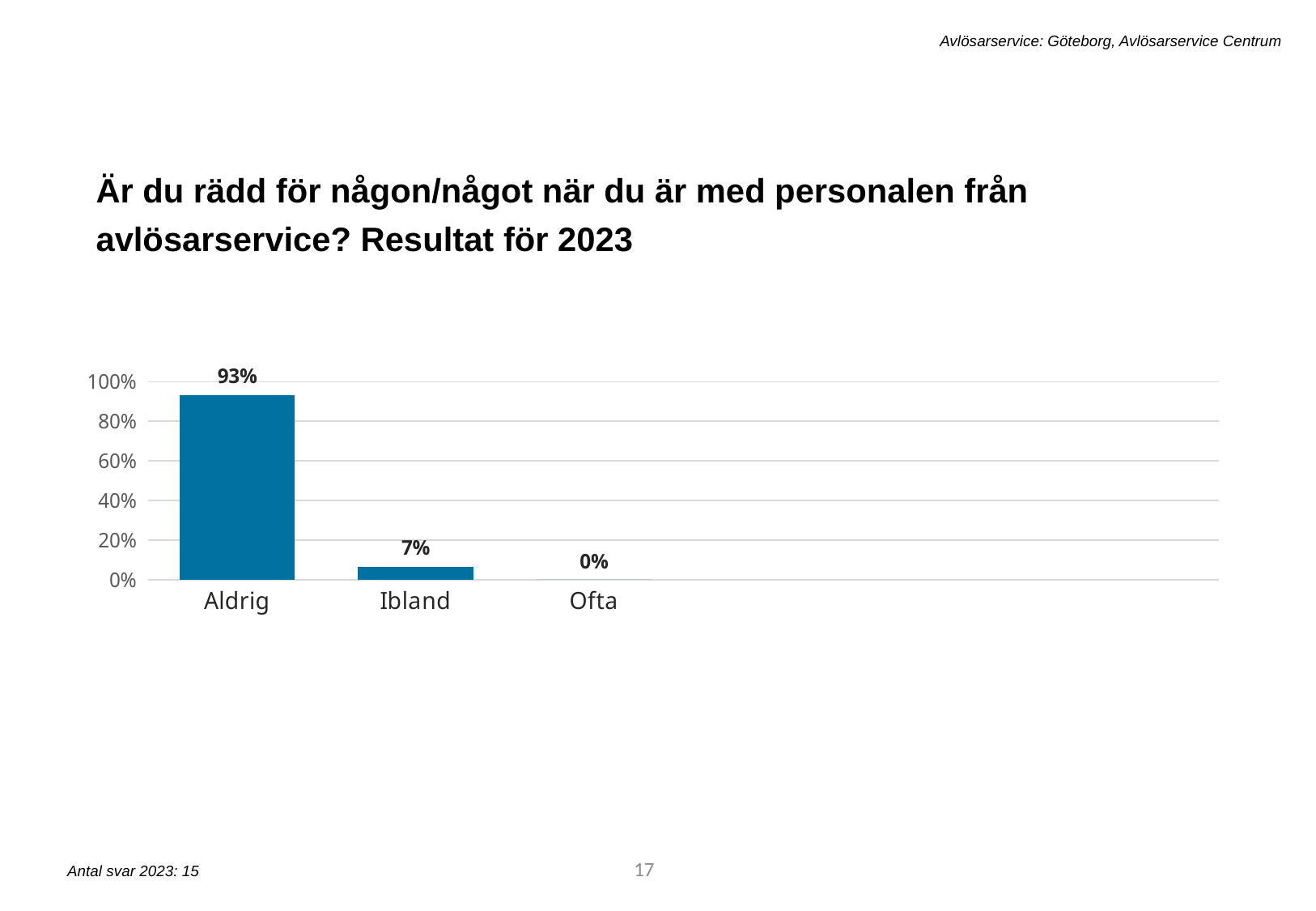
Is the value for Ibland greater or less than 20%? less What kind of chart is shown on the slide? bar chart Do the values rise or fall from left to right along the x axis? fall What is the value for Ofta? 0% Which category has the highest value? Aldrig What is the value for Ibland? 7% Which is larger, the value for Ibland or the value for Ofta? Ibland What is the difference between the values for Aldrig and Ibland? 86% Which category has the lowest value? Ofta How many categories are shown on the x axis? 3 Is the value for Aldrig greater or less than 80%? greater What is the value for Aldrig? 93%